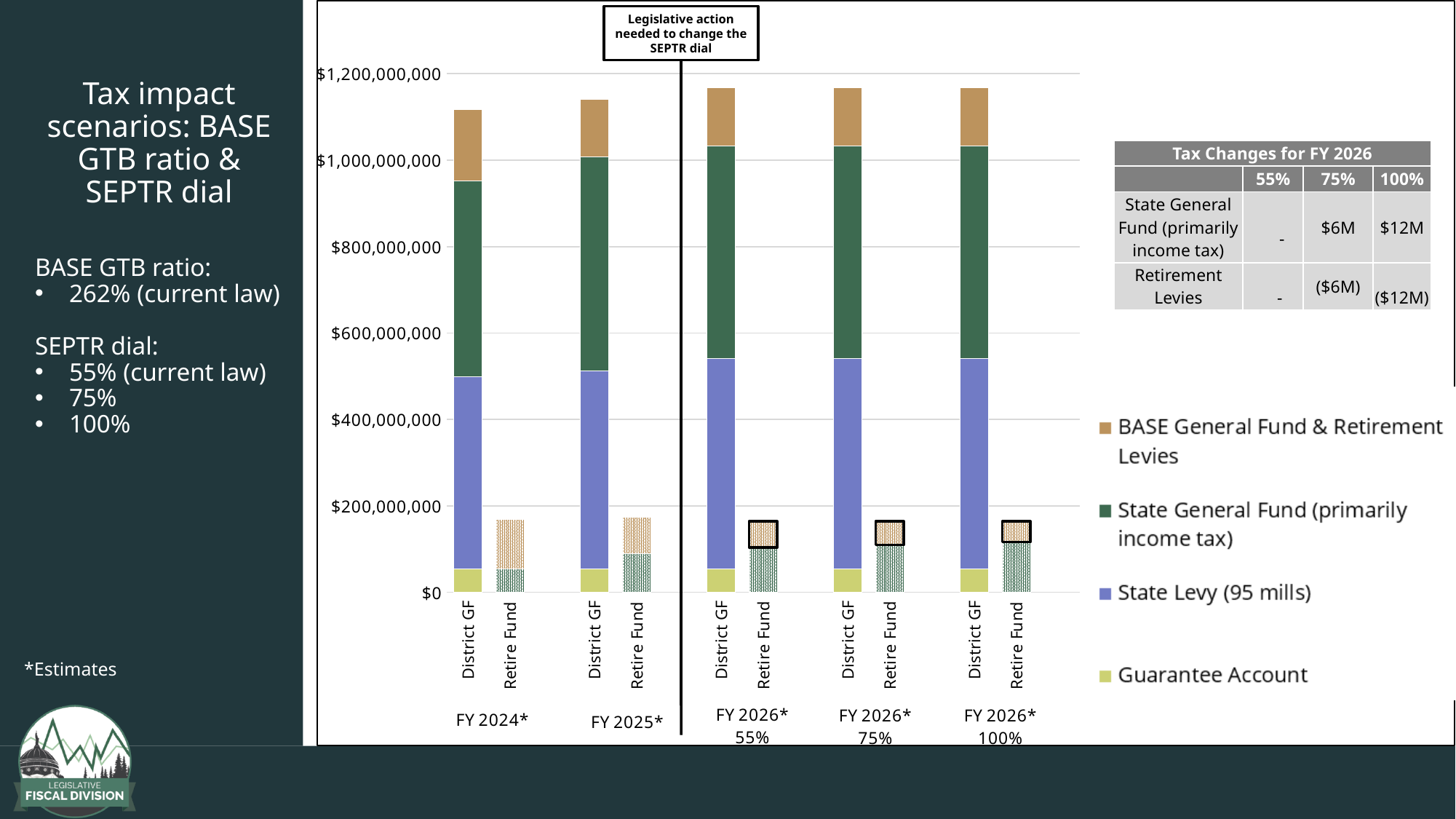
What kind of chart is shown on the slide? stacked bar chart How many series does the chart legend list? 4 Is the value of the District GF bar for FY 2026* 55% greater or less than $1,000,000,000? greater What does the boxed annotation above the vertical divider line in the chart say? Legislative action needed to change the SEPTR dial Is the value of the Retire Fund bar for FY 2026* 100% greater or less than $200,000,000? less How many bars are plotted in the chart? 10 Is the value of the Retire Fund bar for FY 2024* greater or less than $200,000,000? less Which of the two bars for FY 2026* 75% is larger: District GF or Retire Fund? District GF Do the District GF bars rise or fall from FY 2024* to FY 2025*? rise In FY 2024*, which bar is larger: District GF or Retire Fund? District GF Which legend series is shown in green? State General Fund (primarily income tax)